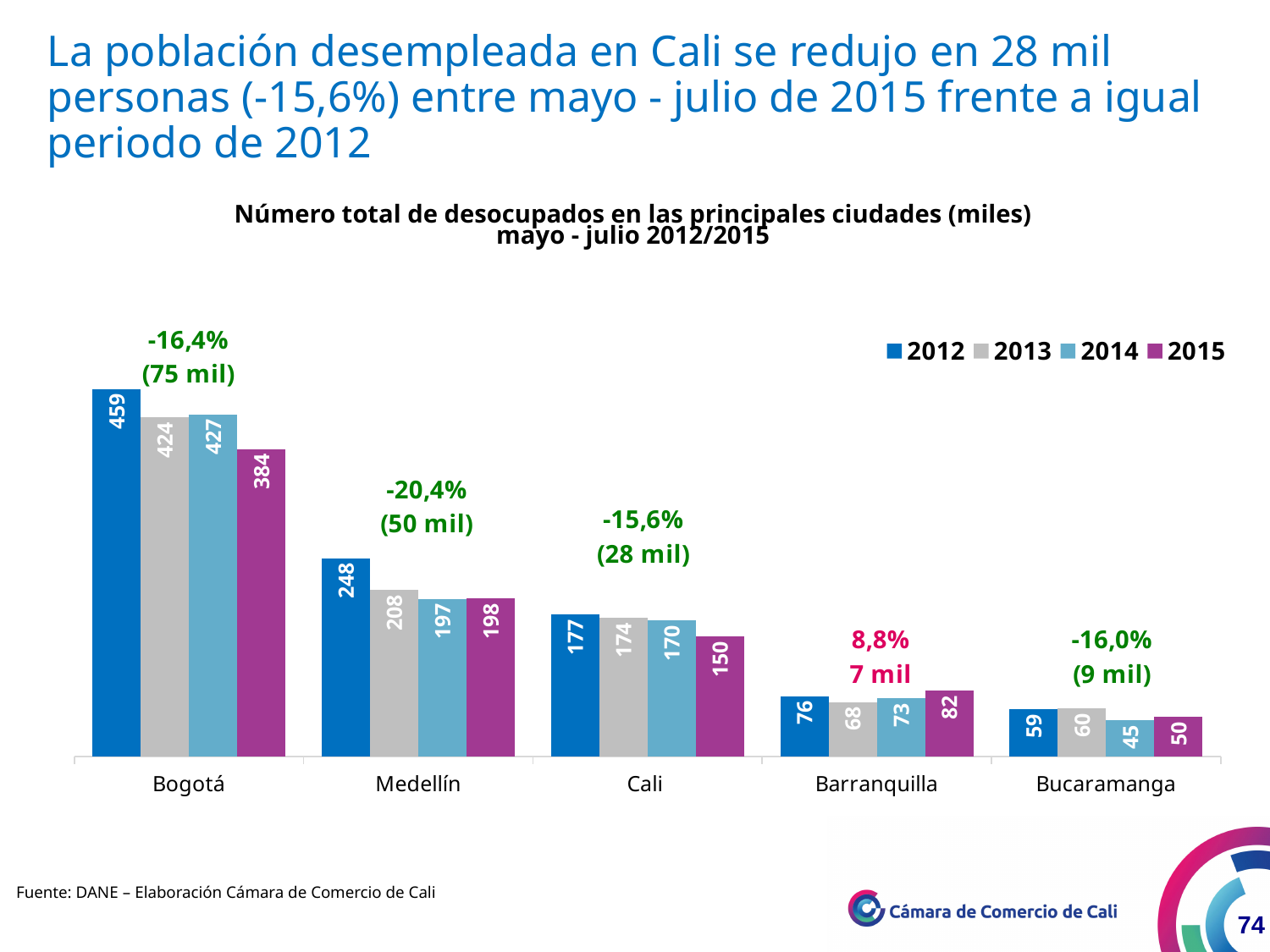
What is the value for Cali in 2015? 150 Which is larger, the 2013 value for Cali or the 2013 value for Medellín? Medellín What is the value for Barranquilla in 2014? 73 What kind of chart is shown? Bar chart What is the difference between the 2012 and 2015 values for Medellín? 50 What percentage change is annotated above the Barranquilla bars? 8,8% How many series does the legend list? 4 How many cities are shown on the x axis? 5 Which city has the highest value in 2015? Bogotá What is the value for Bogotá in 2012? 459 Which city has the lowest value in 2014? Bucaramanga Do the values for Bucaramanga rise or fall from 2012 to 2014? Fall